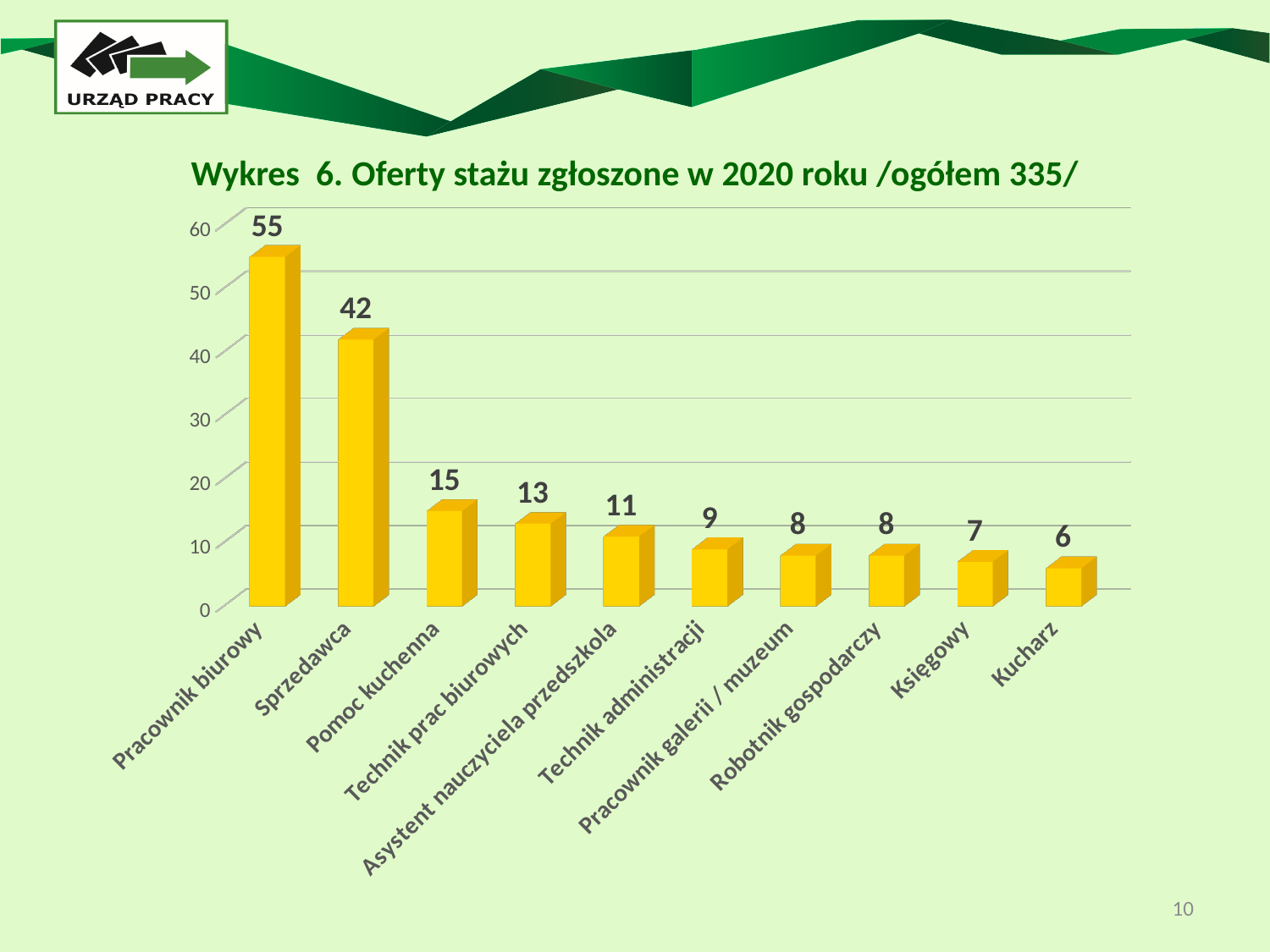
What is the title of the chart? Wykres 6. Oferty stażu zgłoszone w 2020 roku /ogółem 335/ Which category has the lowest value? Kucharz What is the difference between the values for Pracownik biurowy and Sprzedawca? 13 Which is larger, the value for Pomoc kuchenna or the value for Asystent nauczyciela przedszkola? Pomoc kuchenna What is the value for Technik prac biurowych? 13 What is the value for Sprzedawca? 42 What is the value for Pracownik biurowy? 55 How many categories are shown on the chart? 10 Do the values rise or fall from left to right along the x axis? fall What is the value for Kucharz? 6 Which category has the highest value? Pracownik biurowy What kind of chart is shown on the slide? bar chart